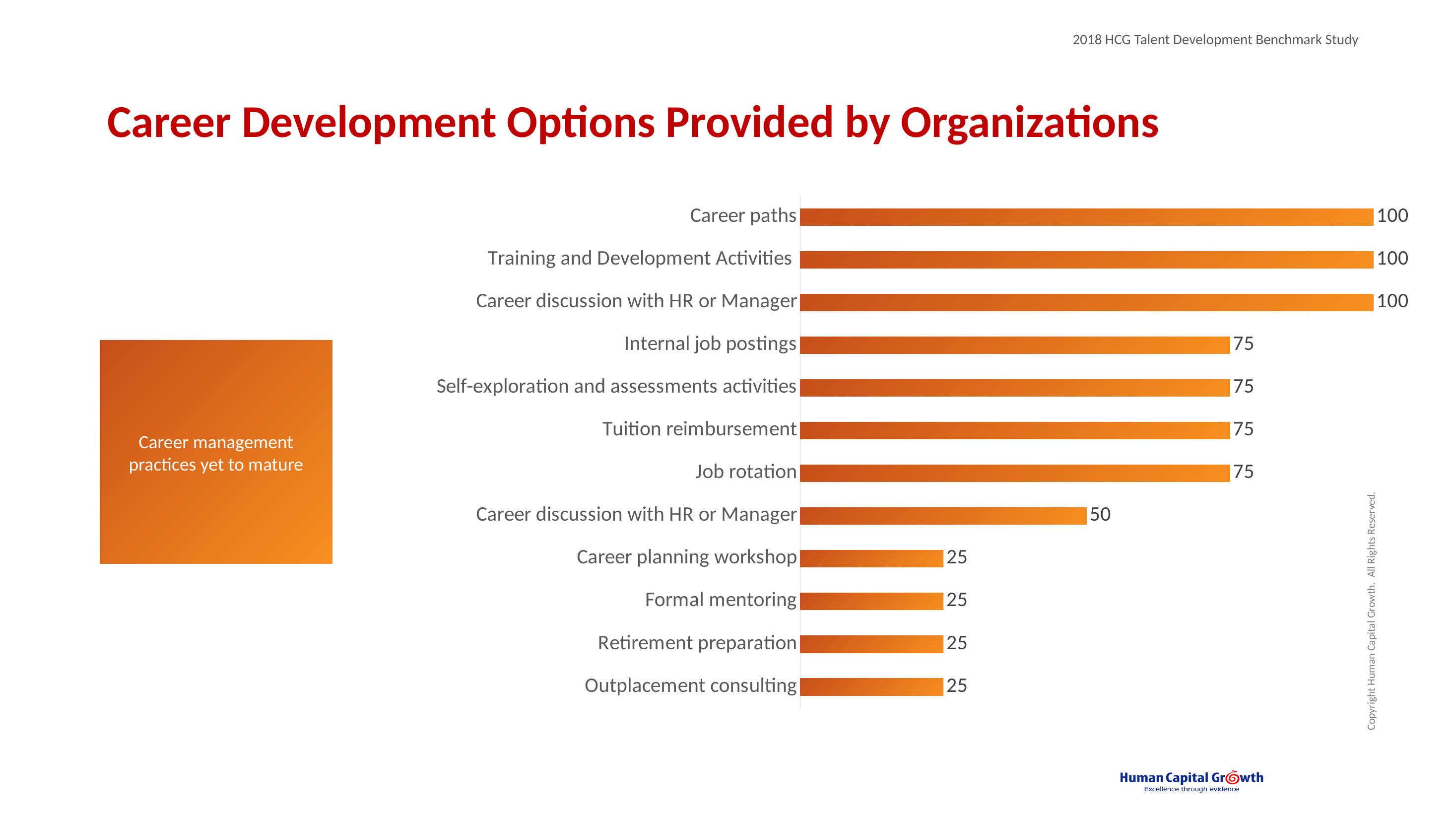
What is the difference between the values for Internal job postings and Outplacement consulting? 50 What is the difference between the values for Career paths and Job rotation? 25 Which has a larger value, Internal job postings or Formal mentoring? Internal job postings What is the highest value shown in the chart? 100 How many categories are shown in the chart? 12 What is the value for Career planning workshop? 25 What is the value for Training and Development Activities? 100 What kind of chart is shown on the slide? Bar chart What is the value for Tuition reimbursement? 75 What is the title of the slide? Career Development Options Provided by Organizations What is the lowest value shown in the chart? 25 What is the value for Job rotation? 75